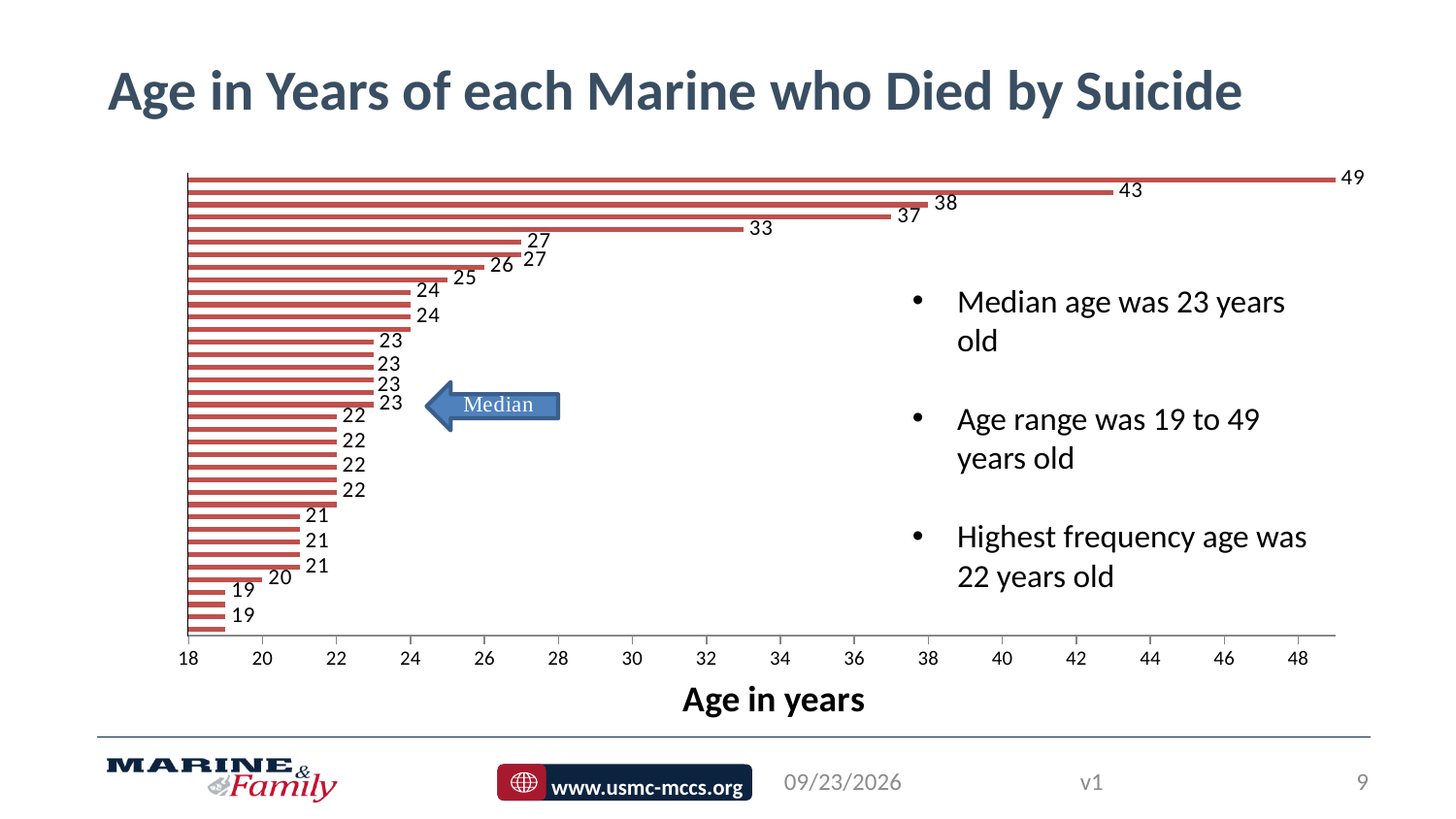
Which is larger, the bar labeled 37 or the bar labeled 33? 37 Is the value of the longest bar greater or less than 48? greater What is the title of the chart? Age in Years of each Marine who Died by Suicide What is the difference between the longest bar (49) and the shortest bar (19)? 30 What value do the bars pointed to by the arrow labeled "Median" have? 23 How many bars in the chart are labeled 23? 6 What is the label on the x axis of the chart? Age in years What is the value of the second-longest bar in the chart? 43 What kind of chart is shown on the slide? bar chart What is the value of the shortest bar in the chart? 19 What is the difference between the bars labeled 43 and 38? 5 What is the value of the longest bar in the chart? 49